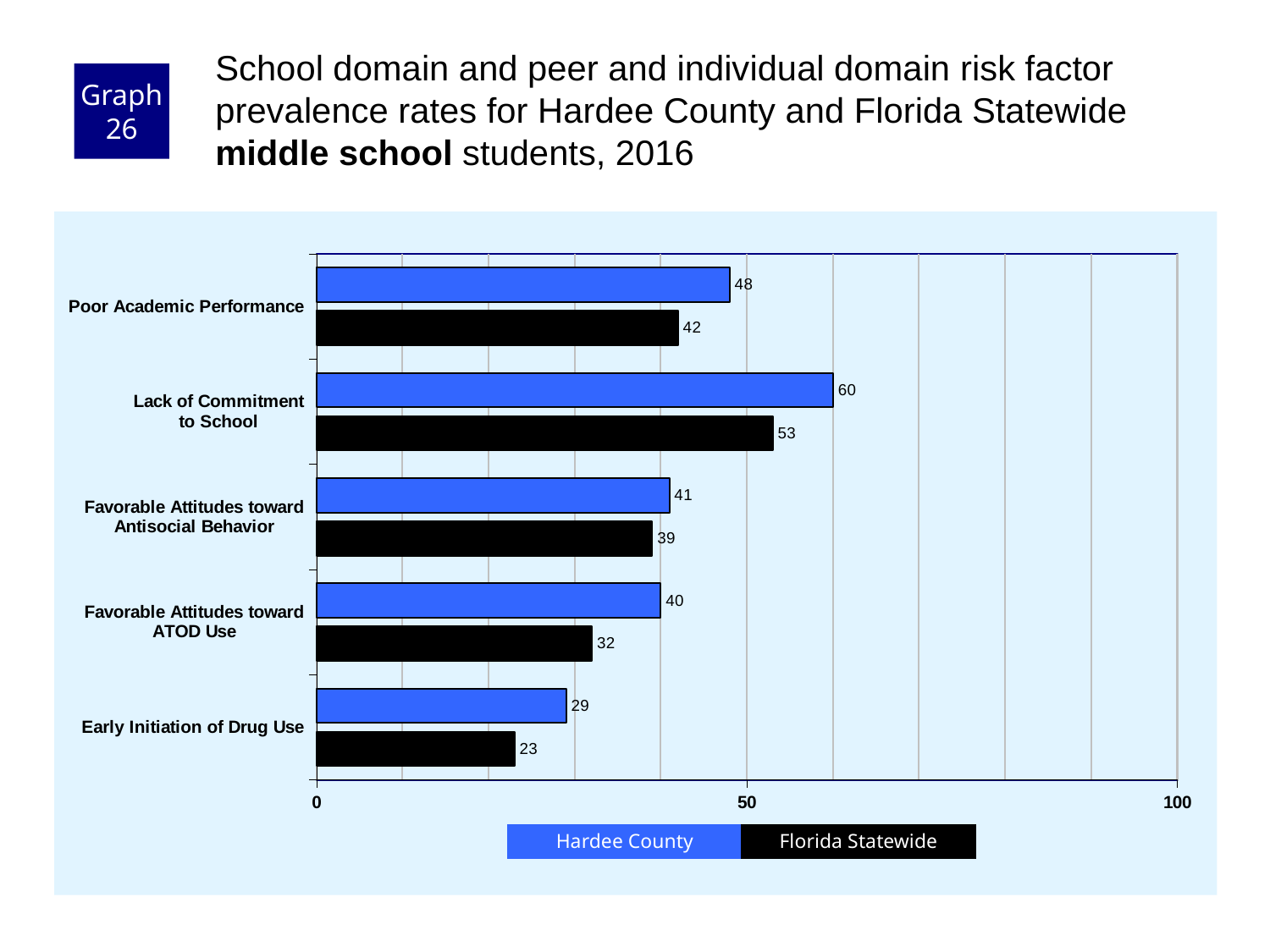
What kind of chart is shown on the slide? bar chart What is the Florida Statewide value for Favorable Attitudes toward ATOD Use? 32 How many risk factor categories are shown on the chart? 5 Which is larger for Favorable Attitudes toward ATOD Use: Hardee County or Florida Statewide? Hardee County Is the Hardee County value for Lack of Commitment to School greater or less than 50? greater What is the Hardee County value for Lack of Commitment to School? 60 What is the Florida Statewide value for Early Initiation of Drug Use? 23 Which risk factor has the highest Hardee County value? Lack of Commitment to School What is the difference between the Hardee County and Florida Statewide values for Poor Academic Performance? 6 Which colour represents Florida Statewide in the chart? black Which risk factor has the lowest Florida Statewide value? Early Initiation of Drug Use How many series does the legend list? 2